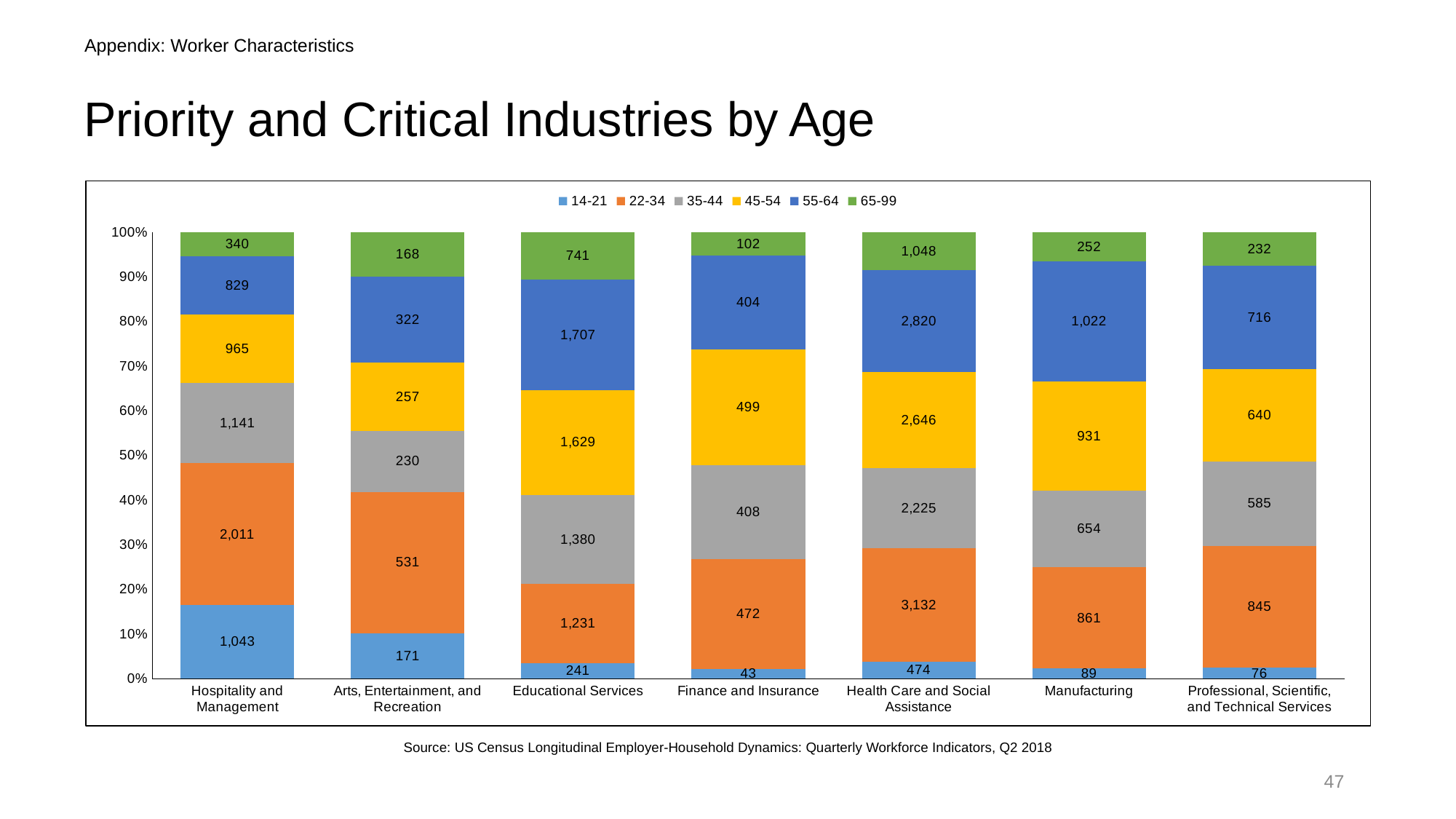
What is the value for the 14-21 age group in Manufacturing? 89 How many age groups does the legend list? 6 Is the share of the 14-21 age group in the Hospitality and Management bar greater or less than 10%? greater What kind of chart is shown on the slide? Stacked bar chart What is the value for the 22-34 age group in Health Care and Social Assistance? 3,132 Which industry has the highest value for the 55-64 age group? Health Care and Social Assistance What is the total of all age groups for Arts, Entertainment, and Recreation? 1,679 Which is larger: the 22-34 value for Hospitality and Management or the 22-34 value for Educational Services? Hospitality and Management What is the difference between the 45-54 and 35-44 values for Manufacturing? 277 How many industries are shown on the x axis? 7 What is the value for the 65-99 age group in Educational Services? 741 Which industry has the lowest value for the 14-21 age group? Finance and Insurance